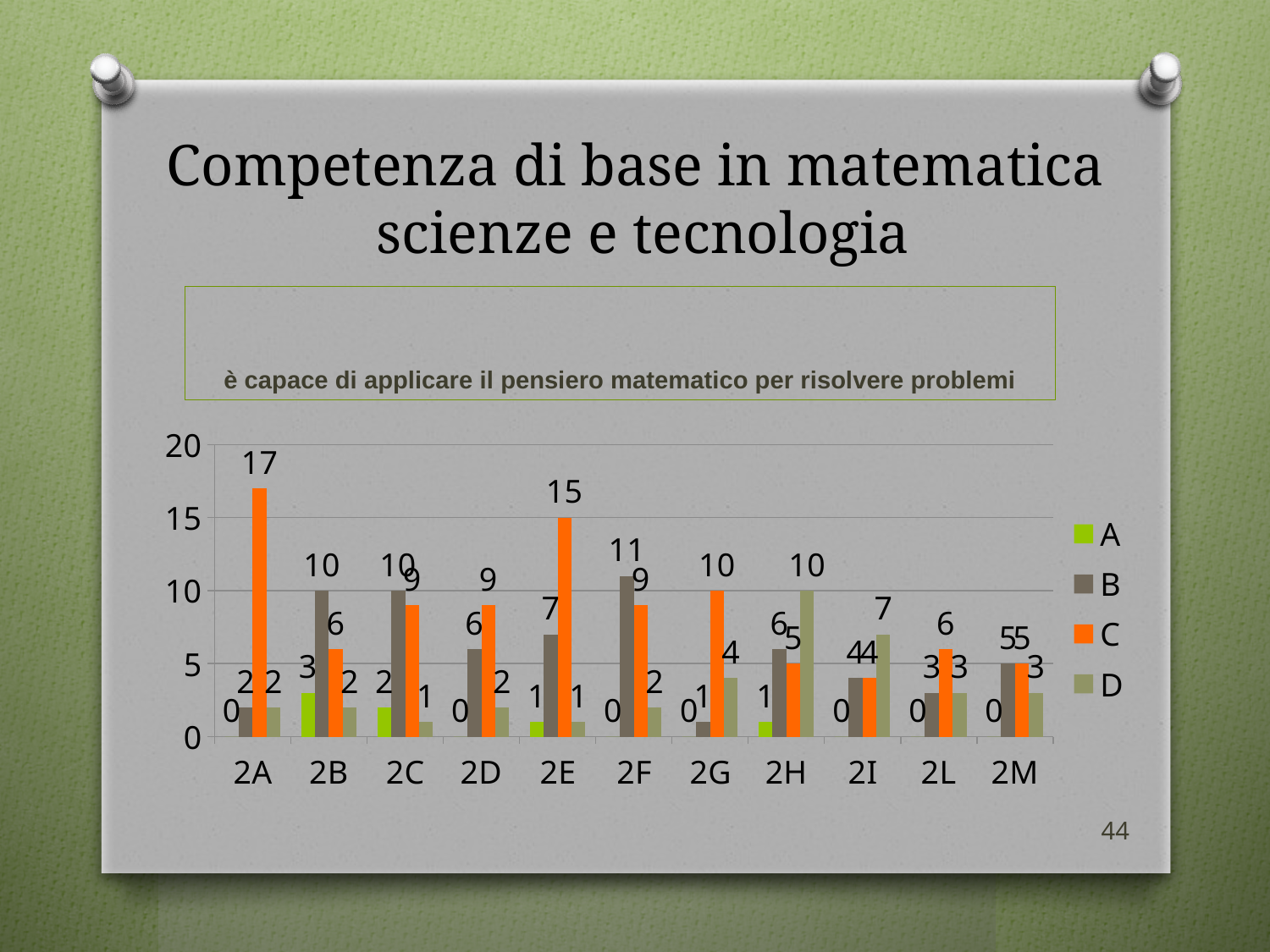
What is the value of series B for class 2F? 11 Which class has the highest value for series C? 2A What is the difference between the series C values for 2A and 2E? 2 What is the value of series A for class 2B? 3 Which class has the highest value for series D? 2H What kind of chart is shown on the slide? bar chart How many series does the legend list? 4 Is the value of series C for class 2E greater or less than 10? greater What is the value of series D for class 2H? 10 How many classes are shown on the x axis? 11 What is the value of series C for class 2A? 17 Which is larger: the series B value for 2F or for 2B? 2F